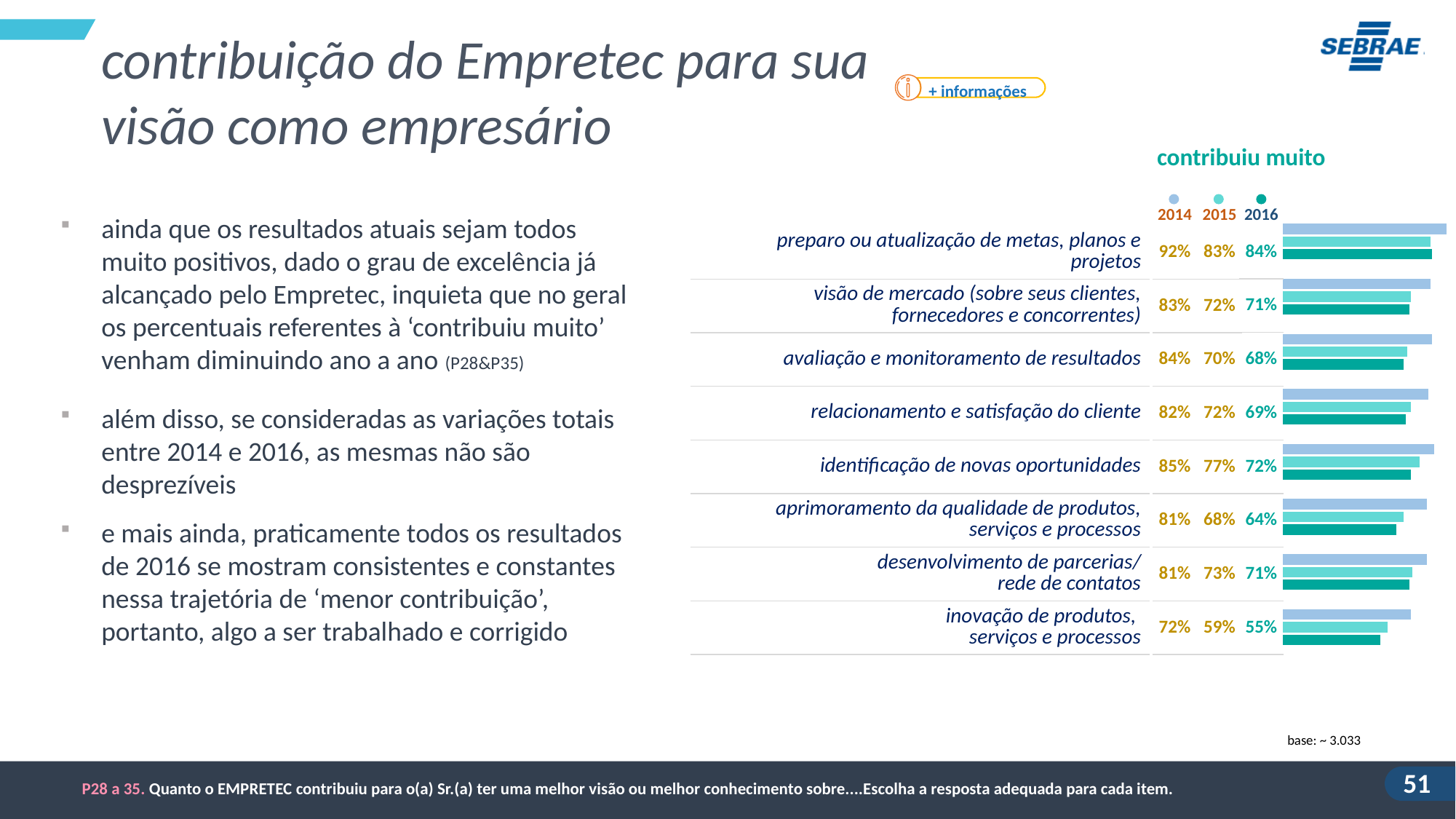
Which years are listed in the chart's legend? 2014, 2015, 2016 What is the 2016 value for 'inovação de produtos, serviços e processos'? 55% How many series does the chart's legend list? 3 Which category has the highest 2016 value? preparo ou atualização de metas, planos e projetos What type of chart is shown on the slide? bar chart Do the values for 'aprimoramento da qualidade de produtos, serviços e processos' rise or fall from 2014 to 2016? fall Which category has the lowest 2014 value? inovação de produtos, serviços e processos What is the 2014 value for 'preparo ou atualização de metas, planos e projetos'? 92% Which is larger for 'preparo ou atualização de metas, planos e projetos': the 2015 value or the 2016 value? 2016 How many categories (items) are plotted in the chart? 8 What is the difference between the 2014 and 2016 values for 'avaliação e monitoramento de resultados'? 16% What is the 2015 value for 'identificação de novas oportunidades'? 77%